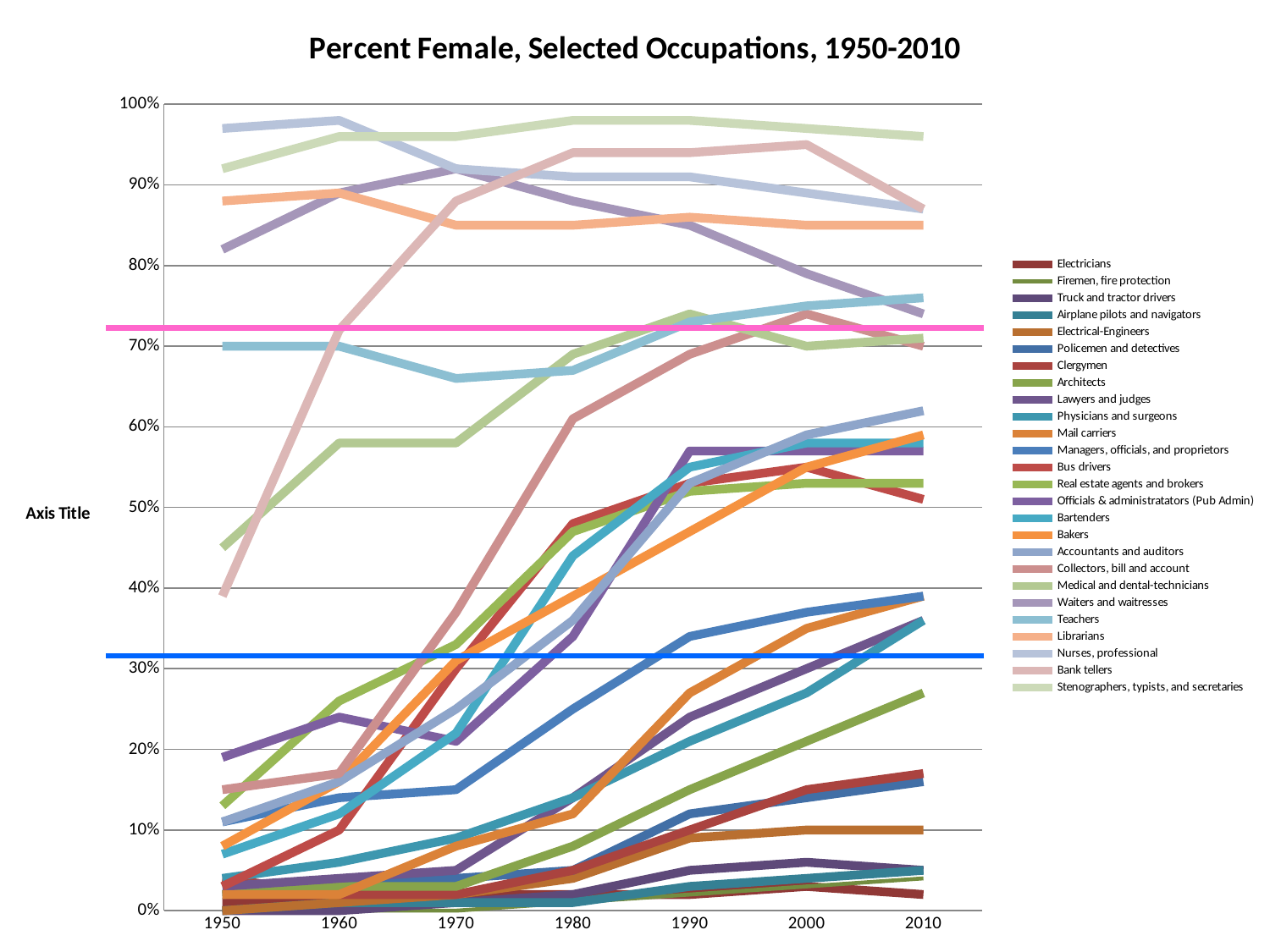
How many years are plotted along the x axis? 7 Is the value for Stenographers, typists, and secretaries in 2010 greater or less than 90%? greater Is the value for Bank tellers in 1950 greater or less than 50%? less Is the value for Librarians in 2010 greater or less than 80%? greater What label is shown on the vertical axis? Axis Title Does the Bank tellers line rise or fall between 1950 and 2000? rise How many series does the legend list? 26 What is the title of the chart? Percent Female, Selected Occupations, 1950-2010 What kind of chart is shown on the slide? line chart